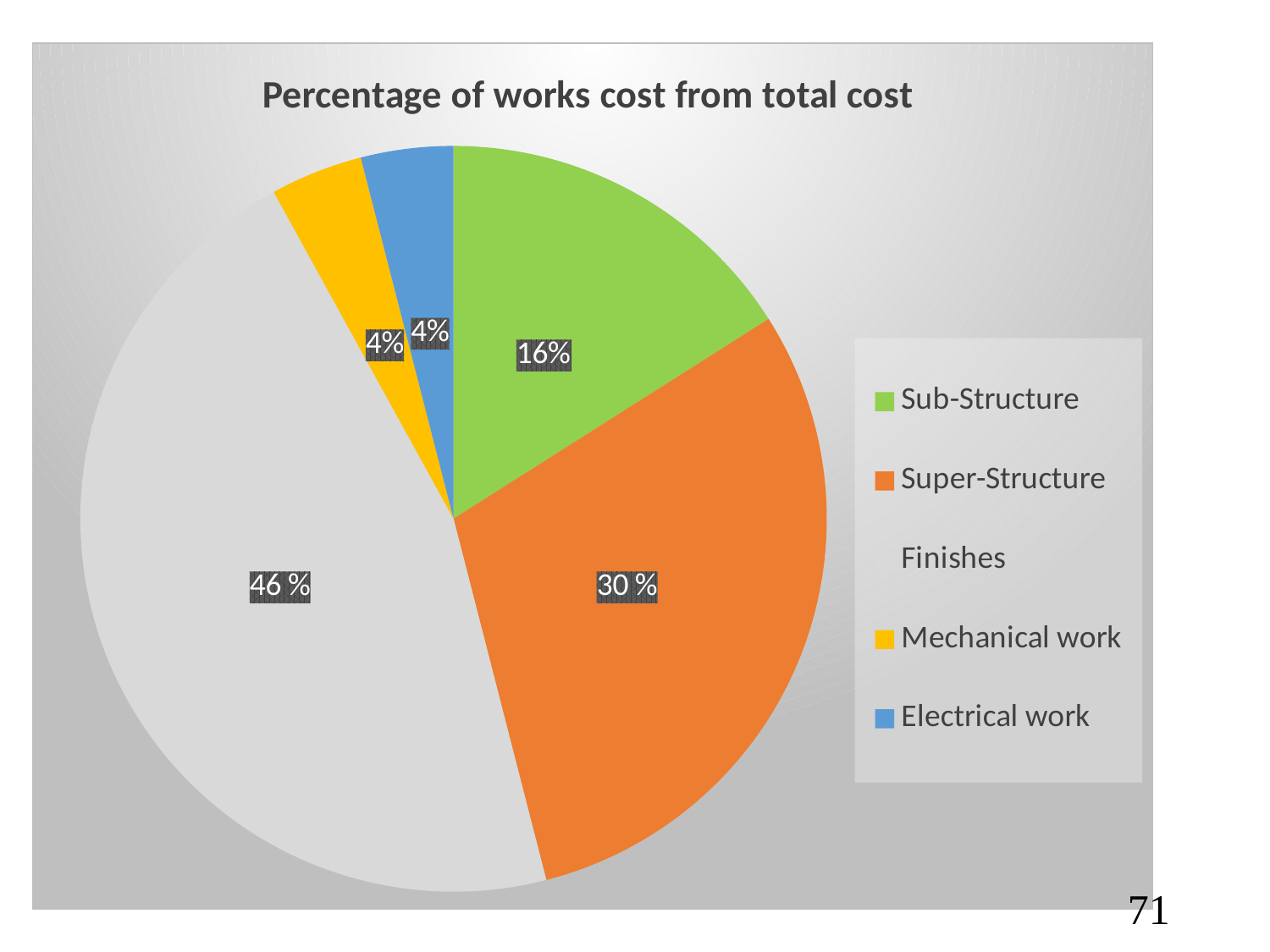
What is the difference in percentage points between Sub-Structure and Electrical work? 12 Which is larger, the share for Super-Structure or the share for Sub-Structure? Super-Structure What is the title of the chart? Percentage of works cost from total cost What is the difference in percentage points between Finishes and Super-Structure? 16 What type of chart is shown on the slide? pie chart How many categories does the legend list? 5 What percentage of the total cost is Finishes? 46 % What percentage of the total cost is Sub-Structure? 16% What percentage of the total cost is Mechanical work? 4% Which category has the largest share of the total cost? Finishes What colour represents Mechanical work in the chart? yellow What percentage of the total cost is Super-Structure? 30 %